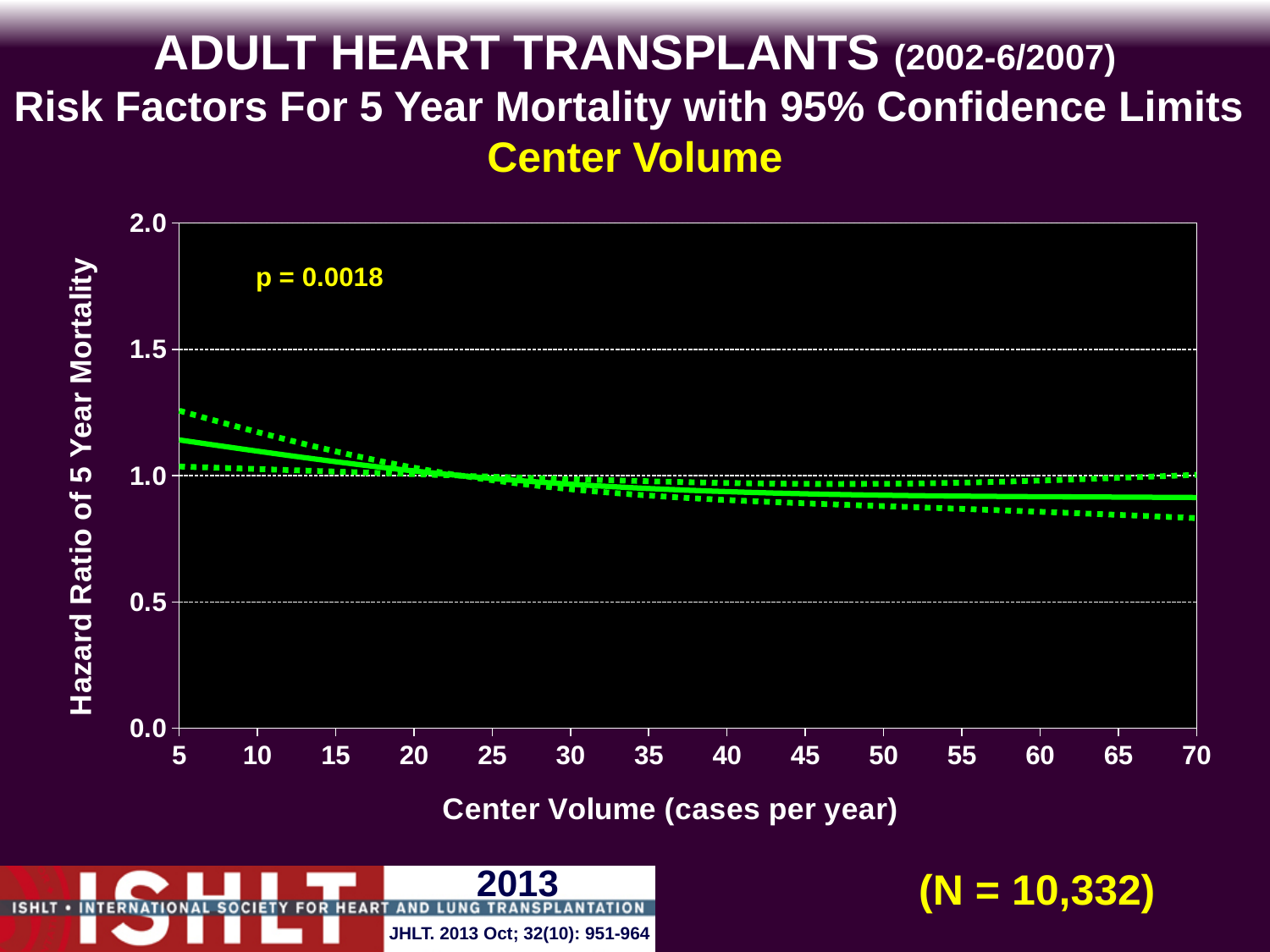
Is the hazard ratio (solid line) at a center volume of 70 cases per year greater or less than 1.0? less What is the sample size (N) shown on the slide? N = 10,332 How many tick marks are labeled on the x axis? 14 Is the lower 95% confidence limit at a center volume of 70 cases per year greater or less than 1.0? less What p-value is printed on the chart? p = 0.0018 Which has the larger hazard ratio on the solid line: a center volume of 5 or a center volume of 70 cases per year? 5 Does the hazard ratio of 5 year mortality rise or fall as center volume increases from 5 to 70 cases per year? fall What kind of chart is shown on the slide? line chart Is the hazard ratio (solid line) at a center volume of 5 cases per year greater or less than 1.0? greater How many lines are plotted on the chart? 3